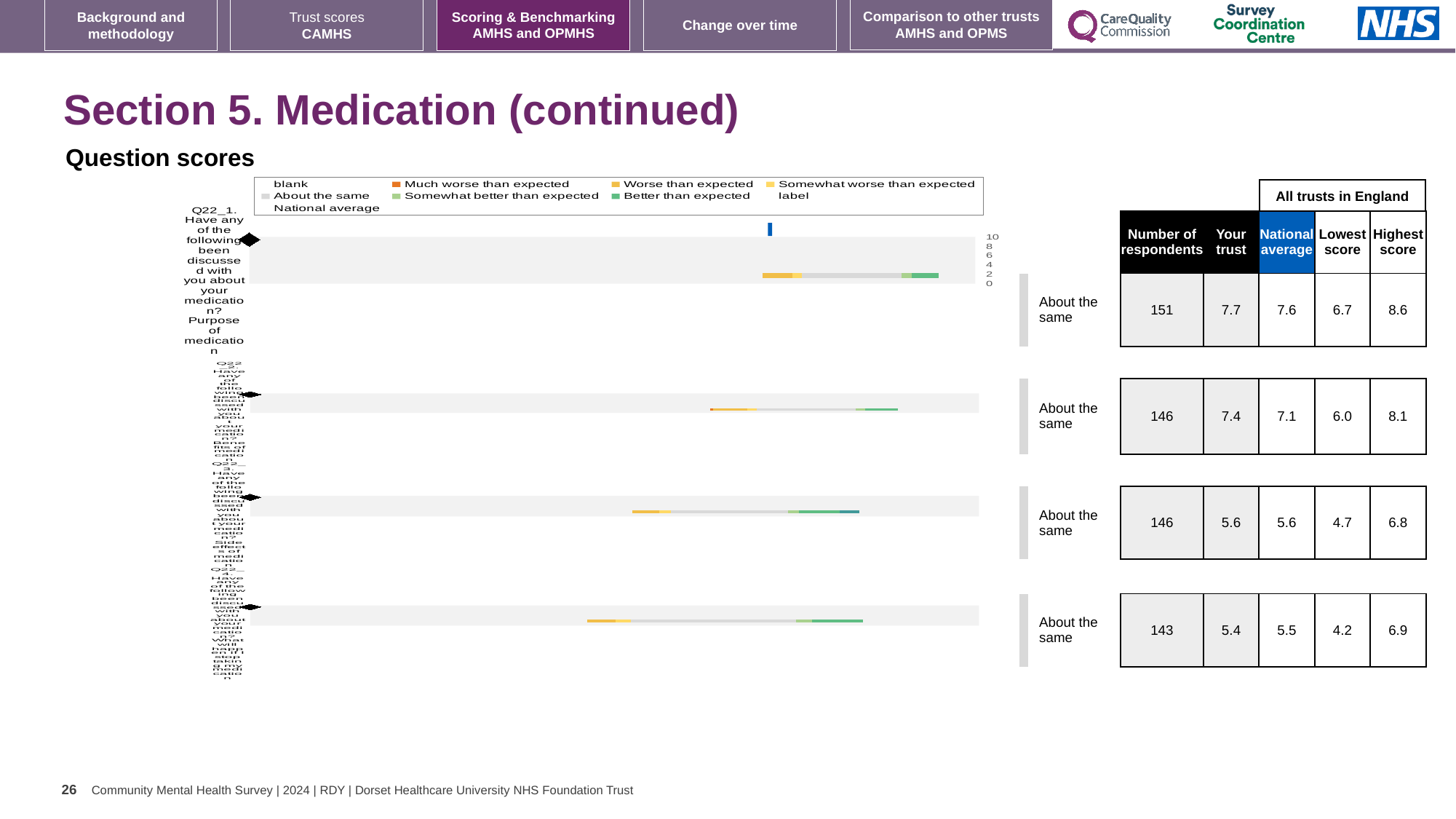
What kind of chart is used to show the question scores on this slide? bar chart How many question score charts (Q22_1 to Q22_4) are shown on the slide? 4 According to the table, what is the 'Your trust' score for Q22_1 (Purpose of medication)? 7.7 According to the table, what is the highest score across all trusts in England for Q22_2 (Benefits of medication)? 8.1 What is the highest value shown on the horizontal axis of the question score charts? 10 Is the 'Your trust' score for Q22_2 (7.4) larger or smaller than its national average (7.1)? larger According to the table, how many respondents answered Q22_4 (What will happen if I stop taking my medication)? 143 Which of the four questions has the lowest 'Your trust' score in the table? Q22_4 (What will happen if I stop taking my medication) In the chart legend, what colour represents 'Much worse than expected'? orange Which of the four questions has the highest 'Your trust' score in the table? Q22_1 (Purpose of medication) What is the difference between the highest score (8.6) and the lowest score (6.7) for Q22_1 in the table? 1.9 According to the table, what is the national average for Q22_1 (Purpose of medication)? 7.6